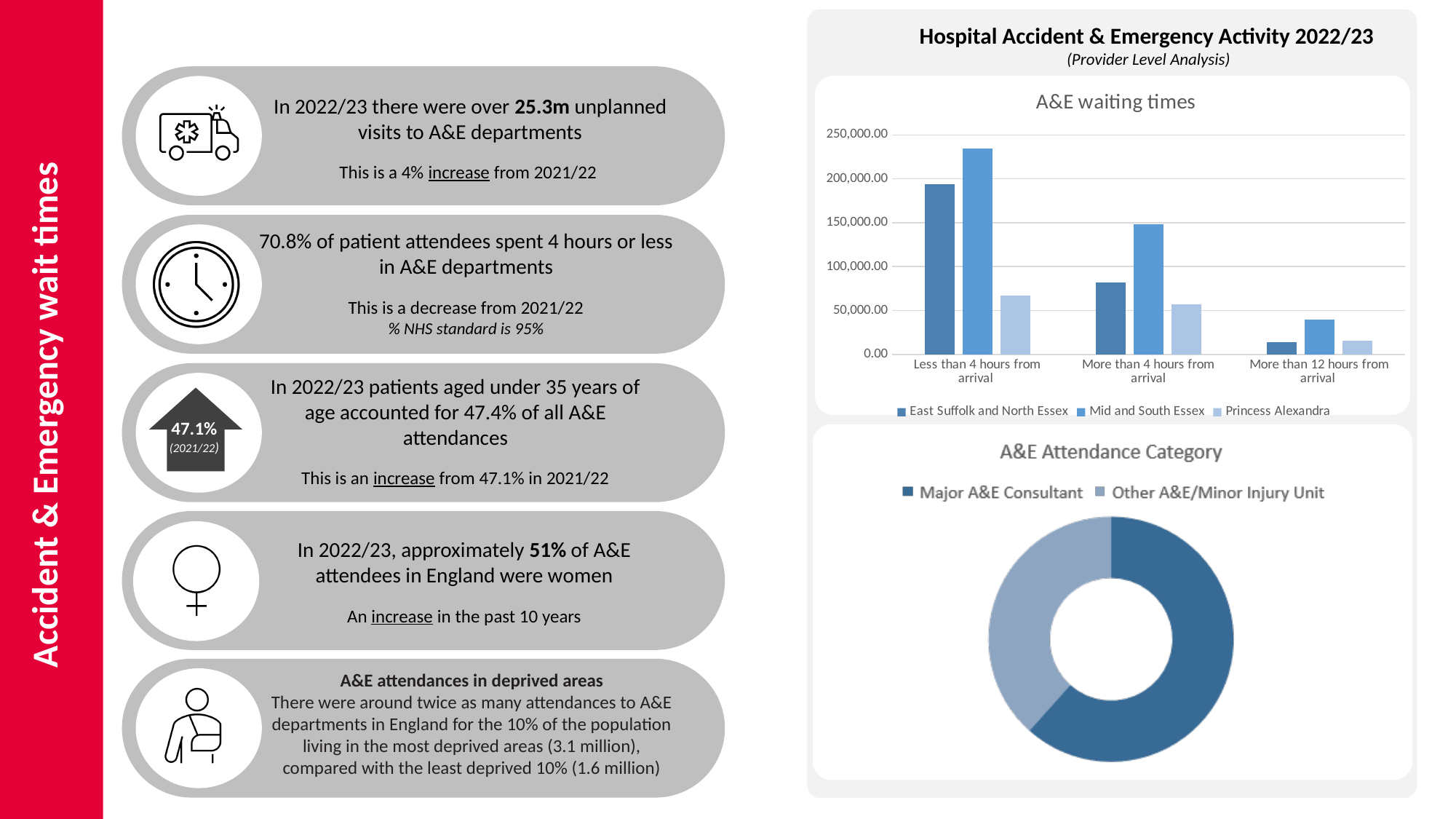
In the 'A&E waiting times' chart, which is larger for 'Less than 4 hours from arrival': East Suffolk and North Essex or Princess Alexandra? East Suffolk and North Essex In the 'A&E waiting times' chart, which provider has the highest value for 'Less than 4 hours from arrival'? Mid and South Essex In the 'A&E waiting times' chart, is the value for Mid and South Essex for 'More than 12 hours from arrival' greater or less than 50,000.00? less In the 'A&E Attendance Category' chart, which segment is larger: Major A&E Consultant or Other A&E/Minor Injury Unit? Major A&E Consultant How many categories are shown on the x axis of the 'A&E waiting times' chart? 3 In the 'A&E waiting times' chart, do the values for Mid and South Essex rise or fall from 'Less than 4 hours from arrival' to 'More than 12 hours from arrival'? fall What type of chart is the 'A&E Attendance Category' chart? doughnut chart How many series does the legend of the 'A&E waiting times' chart list? 3 In the 'A&E waiting times' chart, which provider has the lowest value for 'More than 4 hours from arrival'? Princess Alexandra What type of chart is the 'A&E waiting times' chart? bar chart In the 'A&E waiting times' chart, is the value for Mid and South Essex for 'Less than 4 hours from arrival' greater or less than 200,000.00? greater In the 'A&E waiting times' chart, is the value for East Suffolk and North Essex for 'More than 4 hours from arrival' greater or less than 100,000.00? less